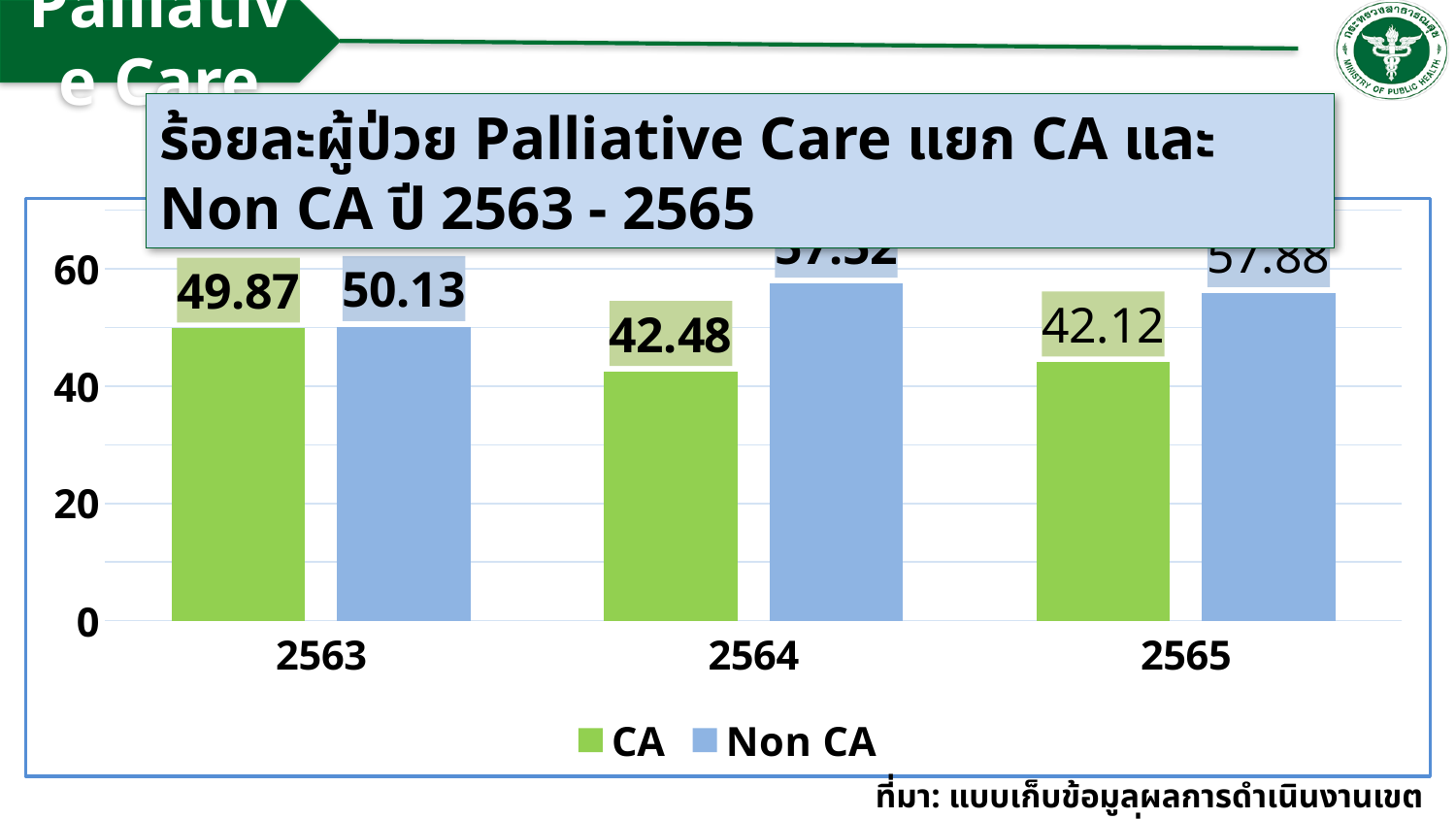
What is the value for CA in 2565? 42.12 What is the value for Non CA in 2563? 50.13 What is the value for CA in 2563? 49.87 How many series does the legend list? 2 In 2565, how much larger is the Non CA value than the CA value? 15.76 Is the value for Non CA in 2564 greater or less than 40? greater In 2563, which is larger, CA or Non CA? Non CA What is the difference between the CA value in 2563 and the CA value in 2565? 7.75 What is the value for Non CA in 2565? 57.88 In which year is the CA value highest? 2563 What is the value for CA in 2564? 42.48